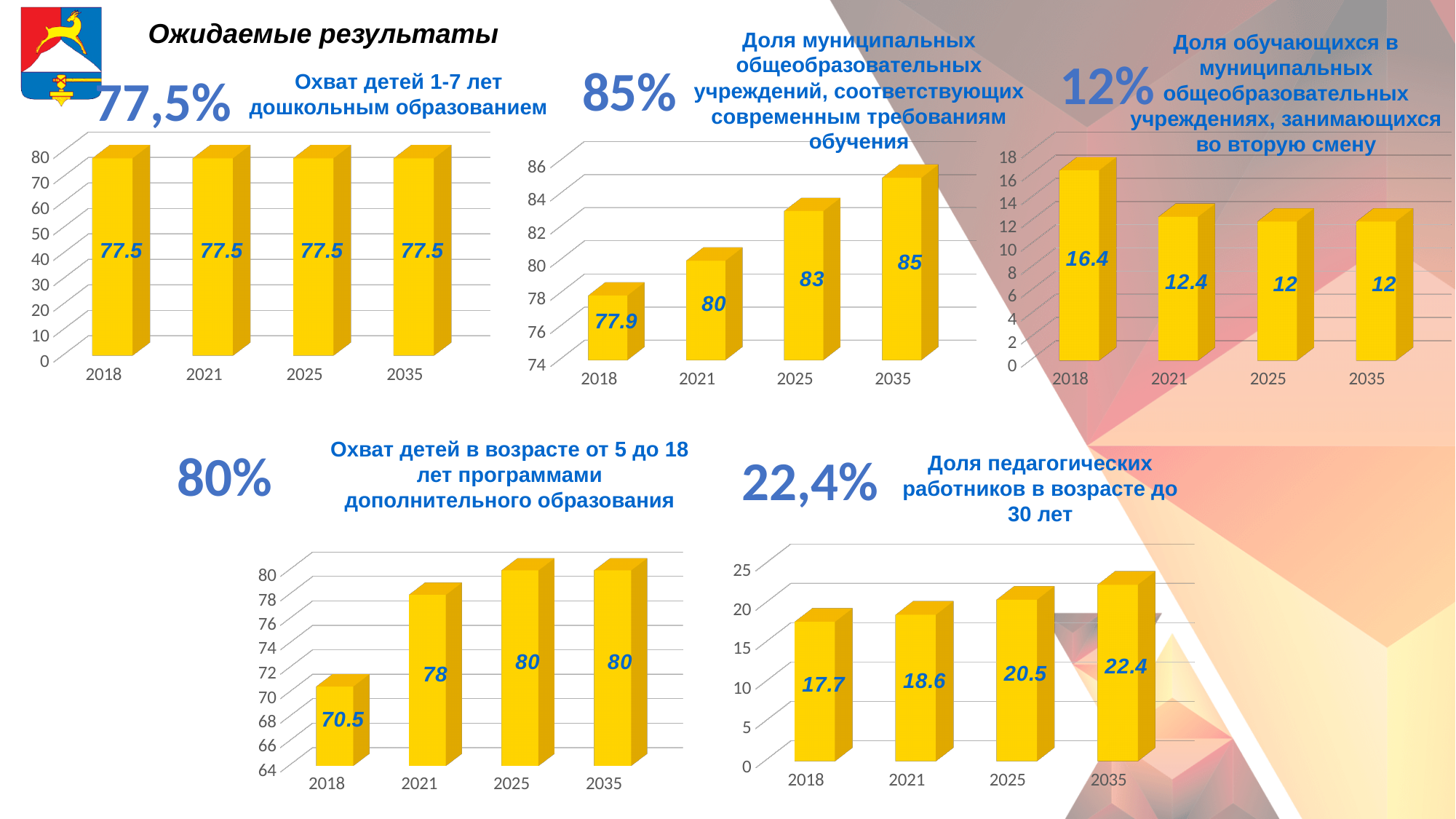
In the chart titled "Доля муниципальных общеобразовательных учреждений, соответствующих современным требованиям обучения", what is the difference between the values for 2035 and 2018? 7.1 In the chart titled "Охват детей 1-7 лет дошкольным образованием", what is the value for 2025? 77.5 In the chart titled "Доля муниципальных общеобразовательных учреждений, соответствующих современным требованиям обучения", what is the value for 2018? 77.9 In the chart titled "Доля обучающихся в муниципальных общеобразовательных учреждениях, занимающихся во вторую смену", is the value for 2018 greater or less than 14? greater In the chart titled "Доля педагогических работников в возрасте до 30 лет", do the values rise or fall from 2018 to 2035? rise In the chart titled "Охват детей в возрасте от 5 до 18 лет программами дополнительного образования", which year has the lowest value? 2018 What kind of chart is the chart titled "Охват детей в возрасте от 5 до 18 лет программами дополнительного образования"? bar chart In the chart titled "Доля педагогических работников в возрасте до 30 лет", which is larger: the value for 2021 or the value for 2025? 2025 In the chart titled "Доля педагогических работников в возрасте до 30 лет", what is the value for 2035? 22.4 How many years are shown on the x axis of the chart titled "Охват детей 1-7 лет дошкольным образованием"? 4 How many charts are shown on the slide? 5 In the chart titled "Доля обучающихся в муниципальных общеобразовательных учреждениях, занимающихся во вторую смену", which year has the highest value? 2018